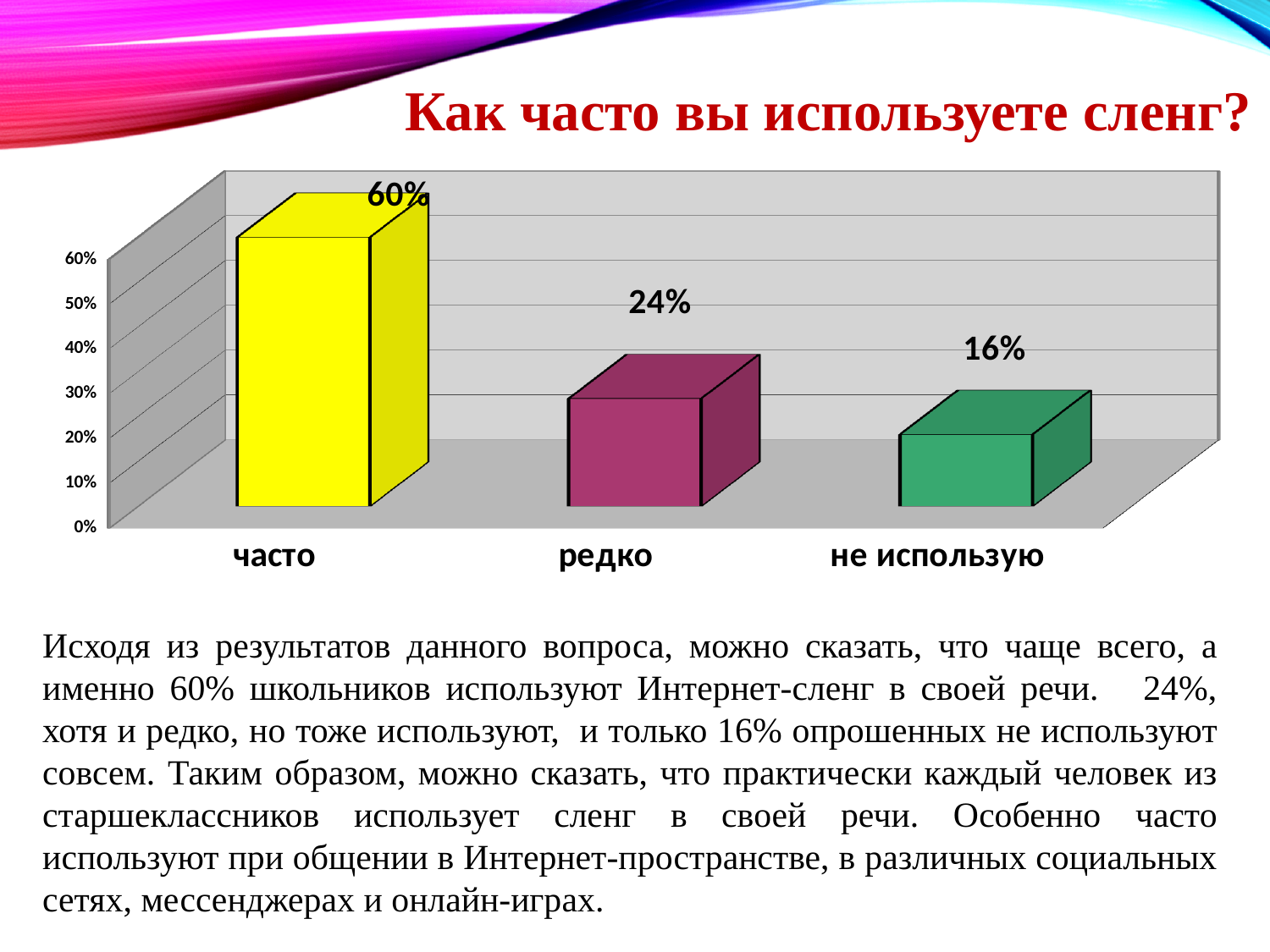
What is the difference between the values for "редко" and "не использую"? 8% Is the value for "часто" greater or less than 50%? greater Which is larger, the value for "редко" or the value for "не использую"? редко What kind of chart is shown on the slide? bar chart What is the value for "не использую"? 16% What is the value for "часто"? 60% What is the value for "редко"? 24% Which category has the highest value? часто Which category has the lowest value? не использую Do the values rise or fall from left to right along the x axis? fall How many categories are shown on the chart? 3 What is the difference between the values for "часто" and "редко"? 36%